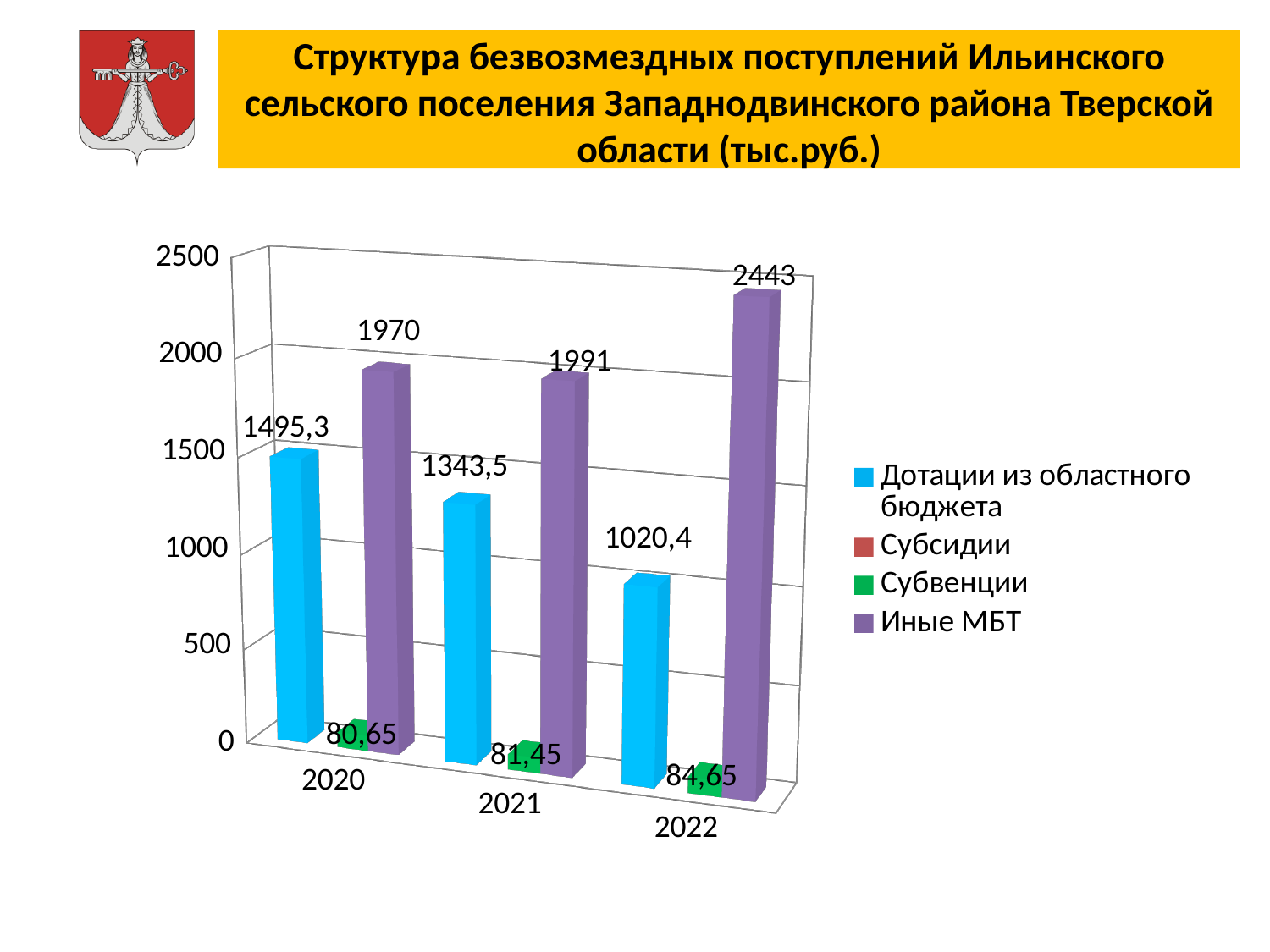
What is the value of Дотации из областного бюджета for 2020? 1495,3 What is the value of Иные МБТ for 2022? 2443 In which year is Иные МБТ the highest? 2022 Do the values of Дотации из областного бюджета rise or fall from 2020 to 2022? fall Which is larger in 2021: Дотации из областного бюджета or Иные МБТ? Иные МБТ What kind of chart is shown on the slide? bar chart How many series does the legend list? 4 What is the value of Субвенции for 2021? 81,45 What colour represents Иные МБТ in the legend? purple How many years are shown on the x axis? 3 In which year is Дотации из областного бюджета the lowest? 2022 What is the difference between Иные МБТ in 2022 and in 2021? 452